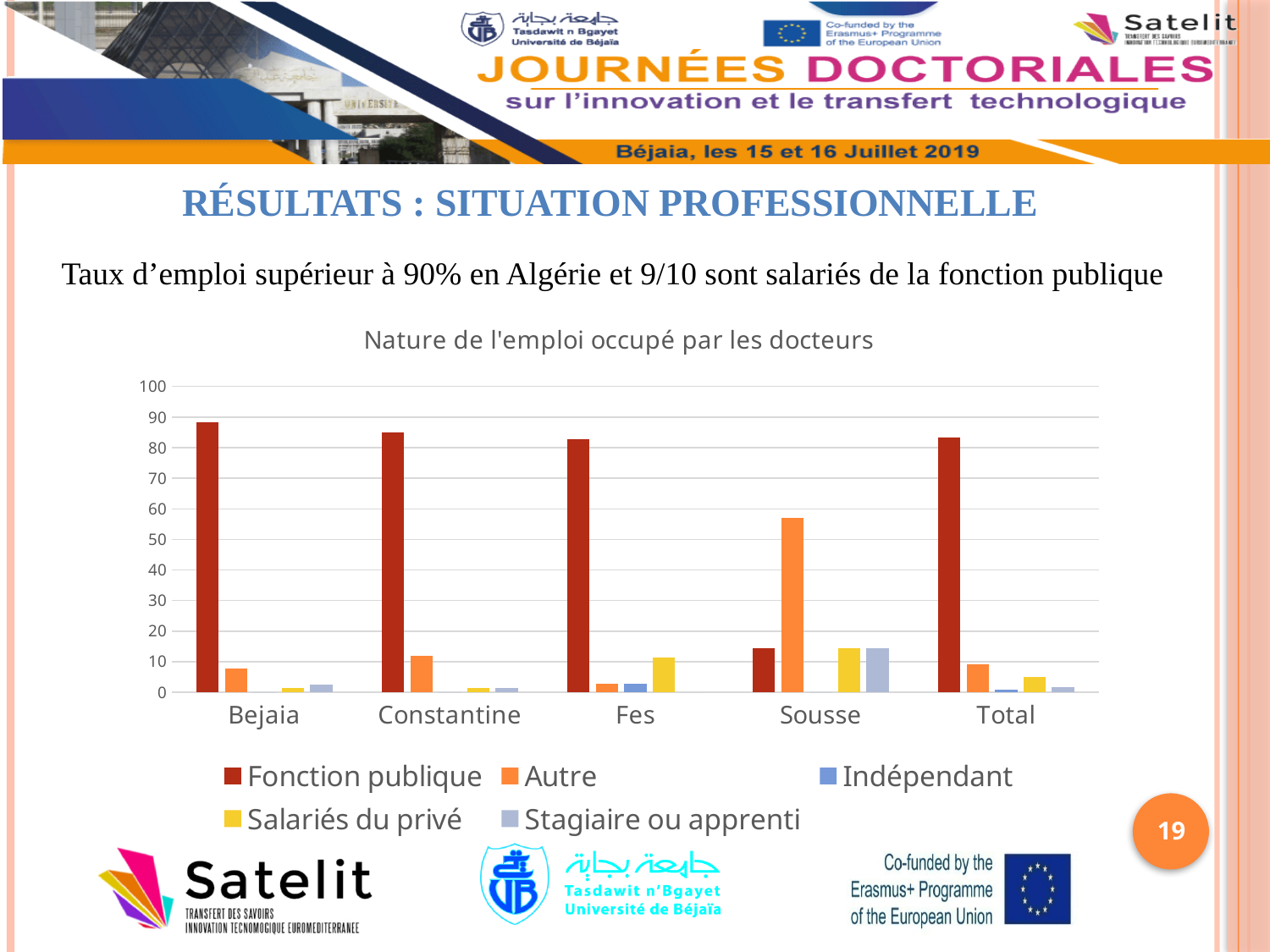
What kind of chart is shown on the slide? Bar chart What is the title of the chart? Nature de l'emploi occupé par les docteurs For Sousse, which is larger: Autre or Fonction publique? Autre Which category has the highest value for the Autre series? Sousse Is the Fonction publique value for Sousse greater or less than 20? less Which category has the lowest value for the Fonction publique series? Sousse How many series does the chart legend list? 5 For Fes, which is larger: Salariés du privé or Autre? Salariés du privé How many categories are shown on the x axis of the chart? 5 Is the Autre value for Sousse greater or less than 50? greater Which series is shown in dark red in the chart legend? Fonction publique Is the Fonction publique value for Bejaia greater or less than 80? greater